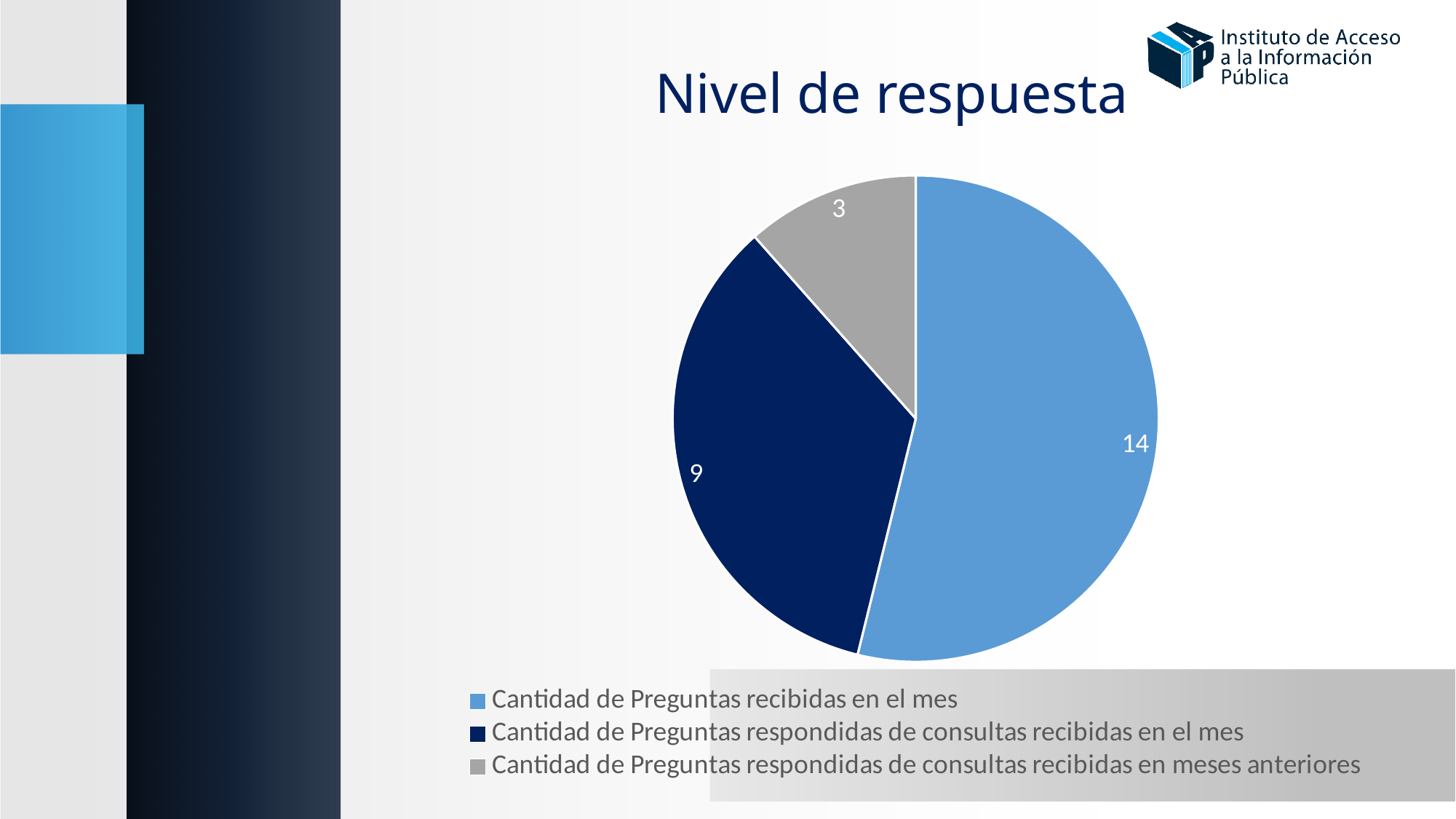
What is the total of all the slices in the pie chart? 26 Which category has the largest slice of the pie? Cantidad de Preguntas recibidas en el mes What is the difference between the value for 'Cantidad de Preguntas recibidas en el mes' and the value for 'Cantidad de Preguntas respondidas de consultas recibidas en el mes'? 5 How many slices does the pie chart have? 3 What is the value for 'Cantidad de Preguntas respondidas de consultas recibidas en el mes'? 9 Which category has the smallest slice of the pie? Cantidad de Preguntas respondidas de consultas recibidas en meses anteriores What is the value for 'Cantidad de Preguntas recibidas en el mes'? 14 What colour is the slice for 'Cantidad de Preguntas respondidas de consultas recibidas en meses anteriores'? grey What is the value for 'Cantidad de Preguntas respondidas de consultas recibidas en meses anteriores'? 3 Which is larger: the value for 'Cantidad de Preguntas respondidas de consultas recibidas en el mes' or the value for 'Cantidad de Preguntas respondidas de consultas recibidas en meses anteriores'? Cantidad de Preguntas respondidas de consultas recibidas en el mes What type of chart is shown on the slide? pie chart What is the title of the chart? Nivel de respuesta